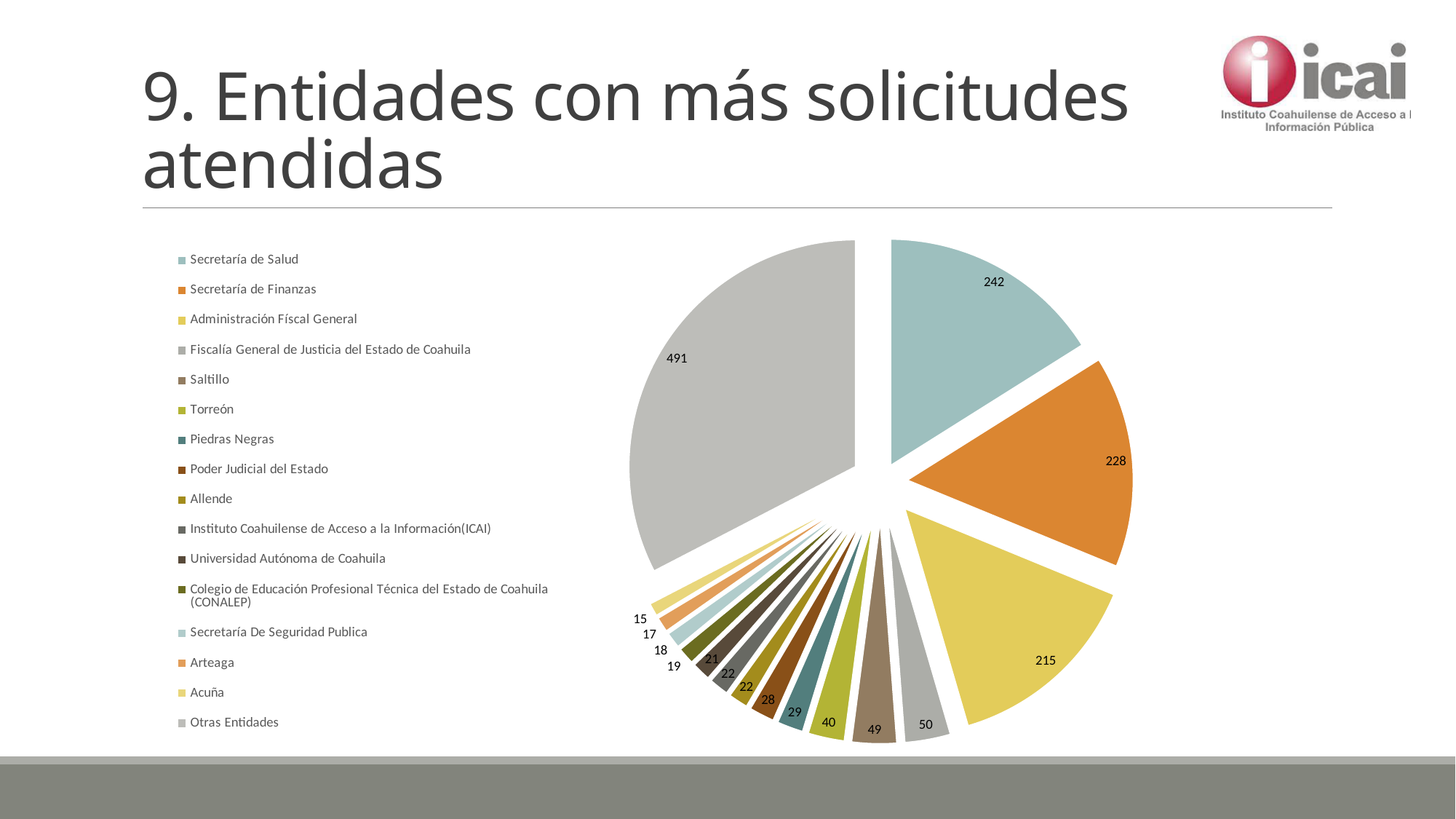
What is the title of the slide containing the chart? 9. Entidades con más solicitudes atendidas What is the difference between the values for Secretaría de Salud and Secretaría de Finanzas? 14 What is the value for Otras Entidades? 491 What is the value for Administración Físcal General? 215 What is the value for Saltillo? 49 How many categories does the pie chart have? 16 What is the value for Secretaría de Salud? 242 Which category has the smallest slice of the pie? Acuña What is the value for Secretaría de Finanzas? 228 Which is larger, the value for Fiscalía General de Justicia del Estado de Coahuila or the value for Torreón? Fiscalía General de Justicia del Estado de Coahuila Which category has the largest slice of the pie? Otras Entidades What kind of chart is shown on the slide? pie chart